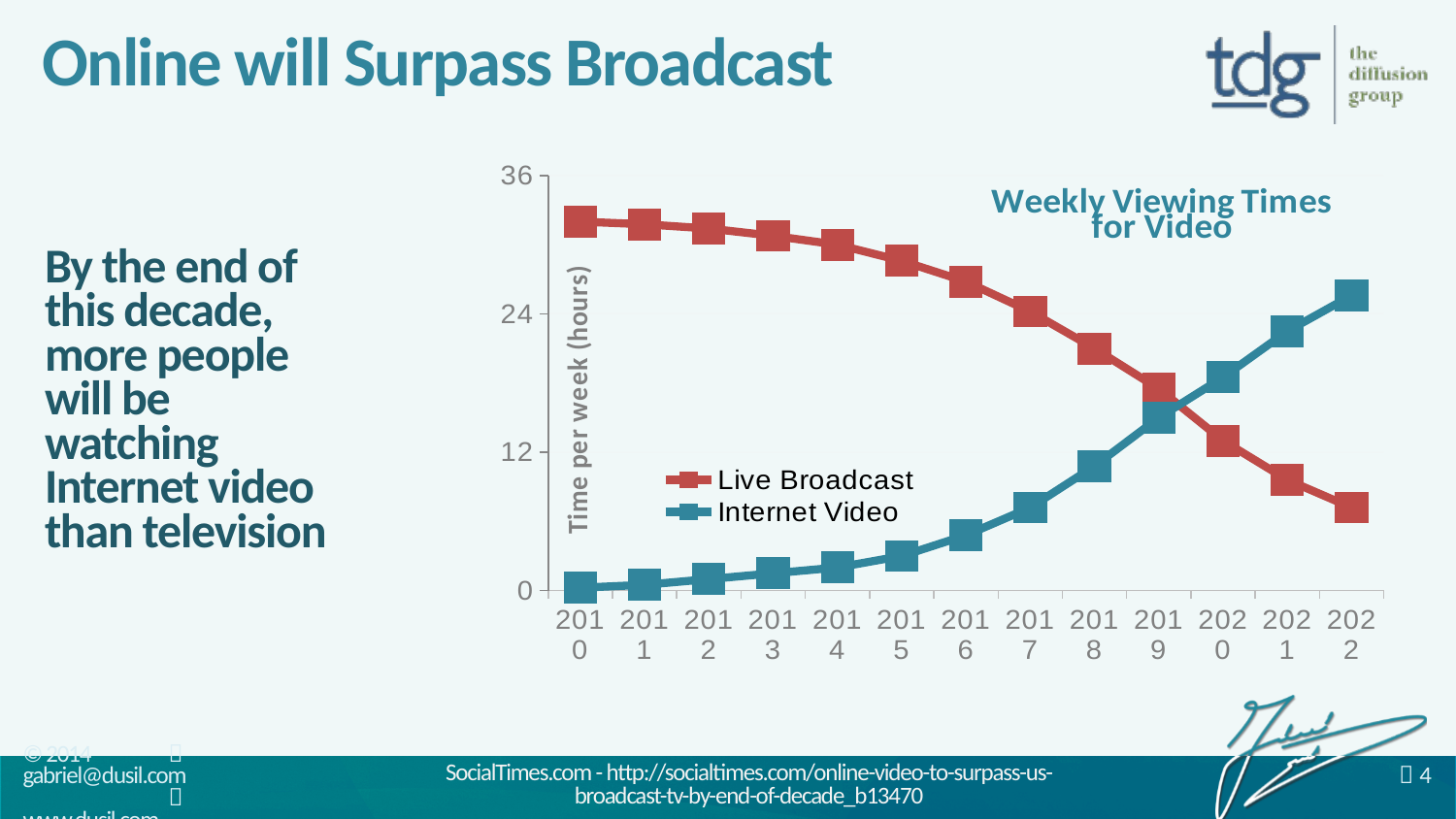
Does the Live Broadcast series rise or fall from 2010 to 2022? fall Does the Internet Video series rise or fall from 2010 to 2022? rise Is the Live Broadcast value for 2022 greater or less than 12? less Is the Internet Video value for 2016 greater or less than 12? less In 2022, which series has the larger value, Live Broadcast or Internet Video? Internet Video What kind of chart is shown on the slide? line chart What is the label on the vertical axis? Time per week (hours) In which year is the Live Broadcast value highest? 2010 How many series does the legend list? 2 Is the Live Broadcast value for 2010 greater or less than 24? greater In which year is the Internet Video value lowest? 2010 How many years are plotted along the x axis? 13